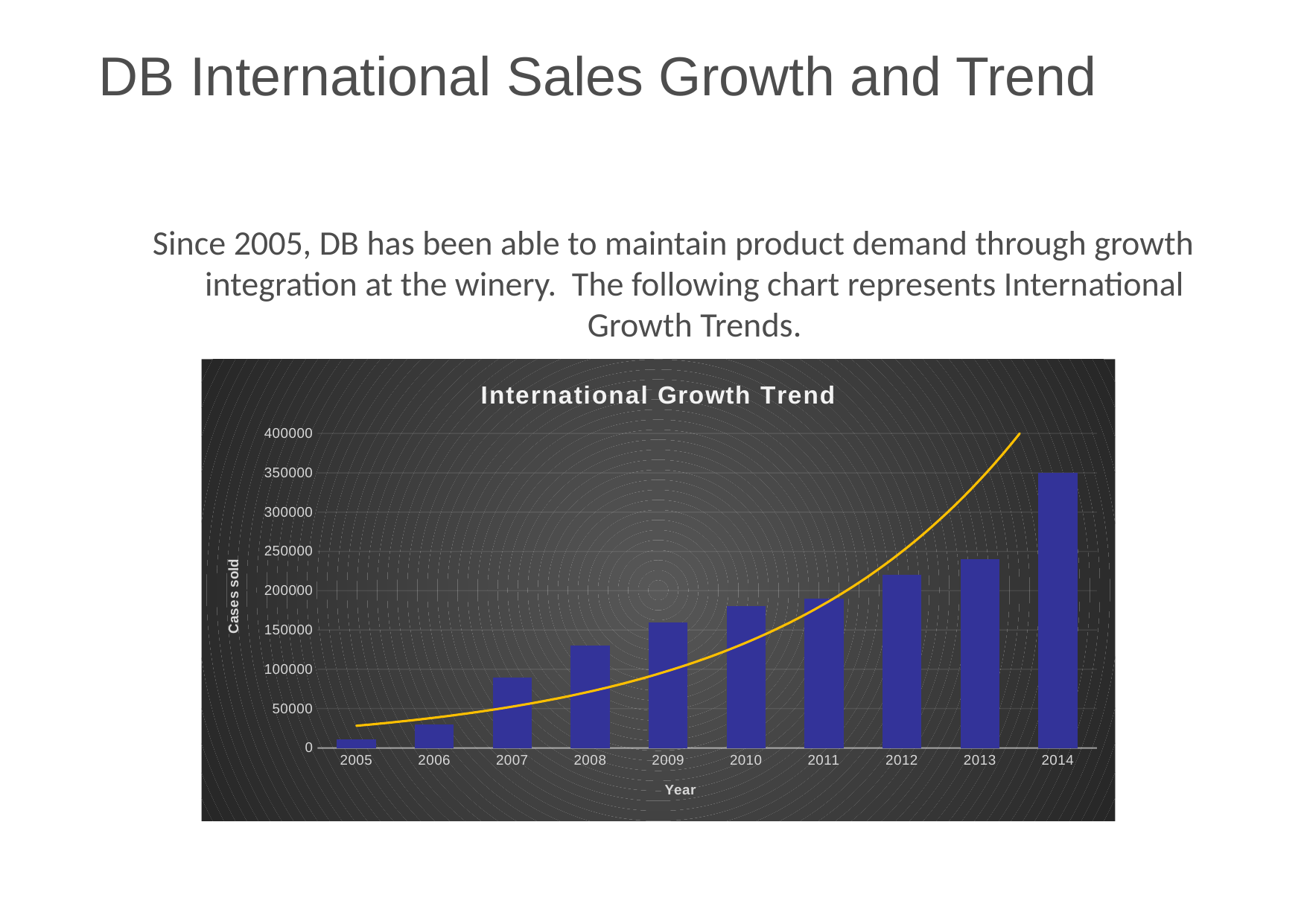
Is the value for 2007 greater or less than 100000? less Which year has the highest number of cases sold? 2014 What type of chart is shown on the slide? Bar chart What is the title of the chart? International Growth Trend What is the label on the vertical axis of the chart? Cases sold Is the value for 2012 greater or less than 200000? greater How many years are shown on the x axis of the chart? 10 Is the value for 2009 greater or less than 150000? greater Do the cases sold rise or fall from 2005 to 2014? Rise Which year has more cases sold, 2009 or 2012? 2012 Which year has the lowest number of cases sold? 2005